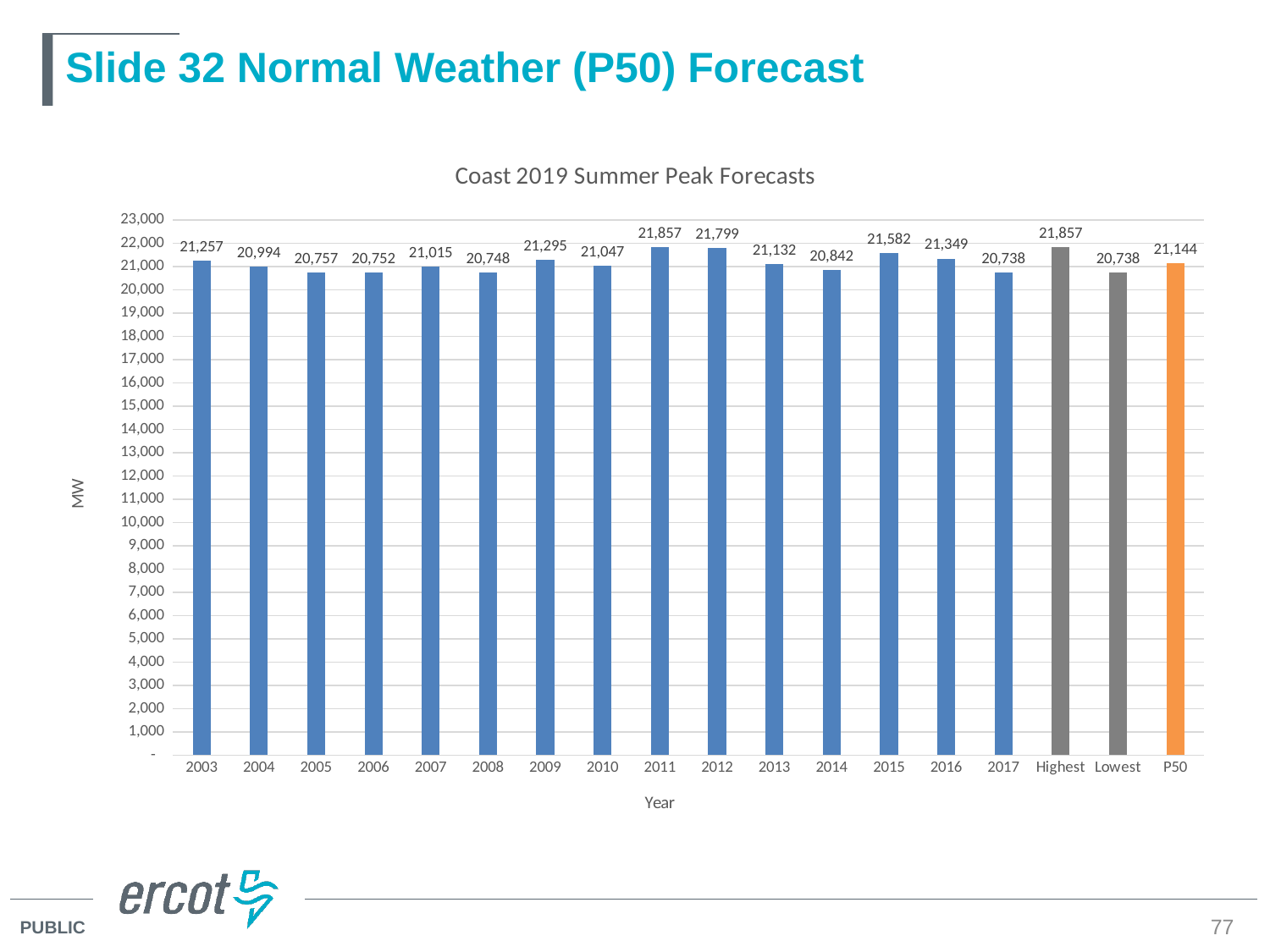
Which year from 2003 to 2017 has the highest value? 2011 What is the label on the vertical axis? MW What kind of chart is shown on the slide? Bar chart What is the value for 2011 in the Coast 2019 Summer Peak Forecasts chart? 21,857 What is the value for 2014? 20,842 Which is larger, the value for 2009 or the value for 2010? 2009 What is the difference between the Highest and Lowest bars? 1,119 What is the value for the P50 bar? 21,144 Which year from 2003 to 2017 has the lowest value? 2017 What is the title of the chart? Coast 2019 Summer Peak Forecasts Is the value for 2015 greater or less than 21,000? greater How many bars are shown in the chart? 18